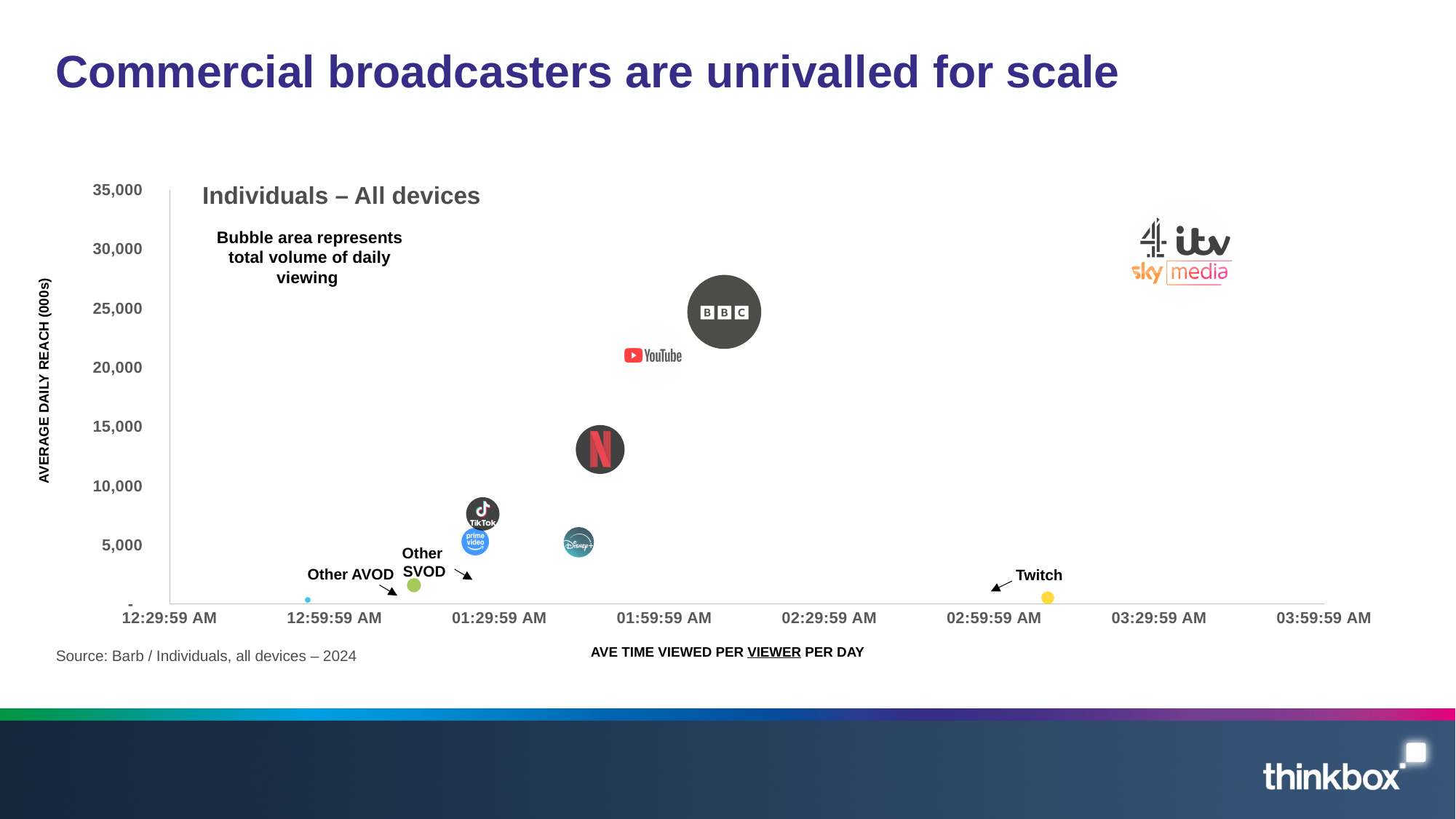
Is the average daily reach for YouTube greater or less than 15,000? greater Which has the higher average daily reach, Netflix or TikTok? Netflix According to the chart note, what does the bubble area represent? total volume of daily viewing What is the label on the vertical axis of the chart? AVERAGE DAILY REACH (000s) What kind of chart is shown on the slide? bubble chart Which has the higher average daily reach, BBC or YouTube? BBC Is the average daily reach for BBC greater or less than 20,000? greater Is the average daily reach for Disney+ greater or less than 10,000? less Which has the longer average time viewed per viewer per day, Twitch or BBC? Twitch